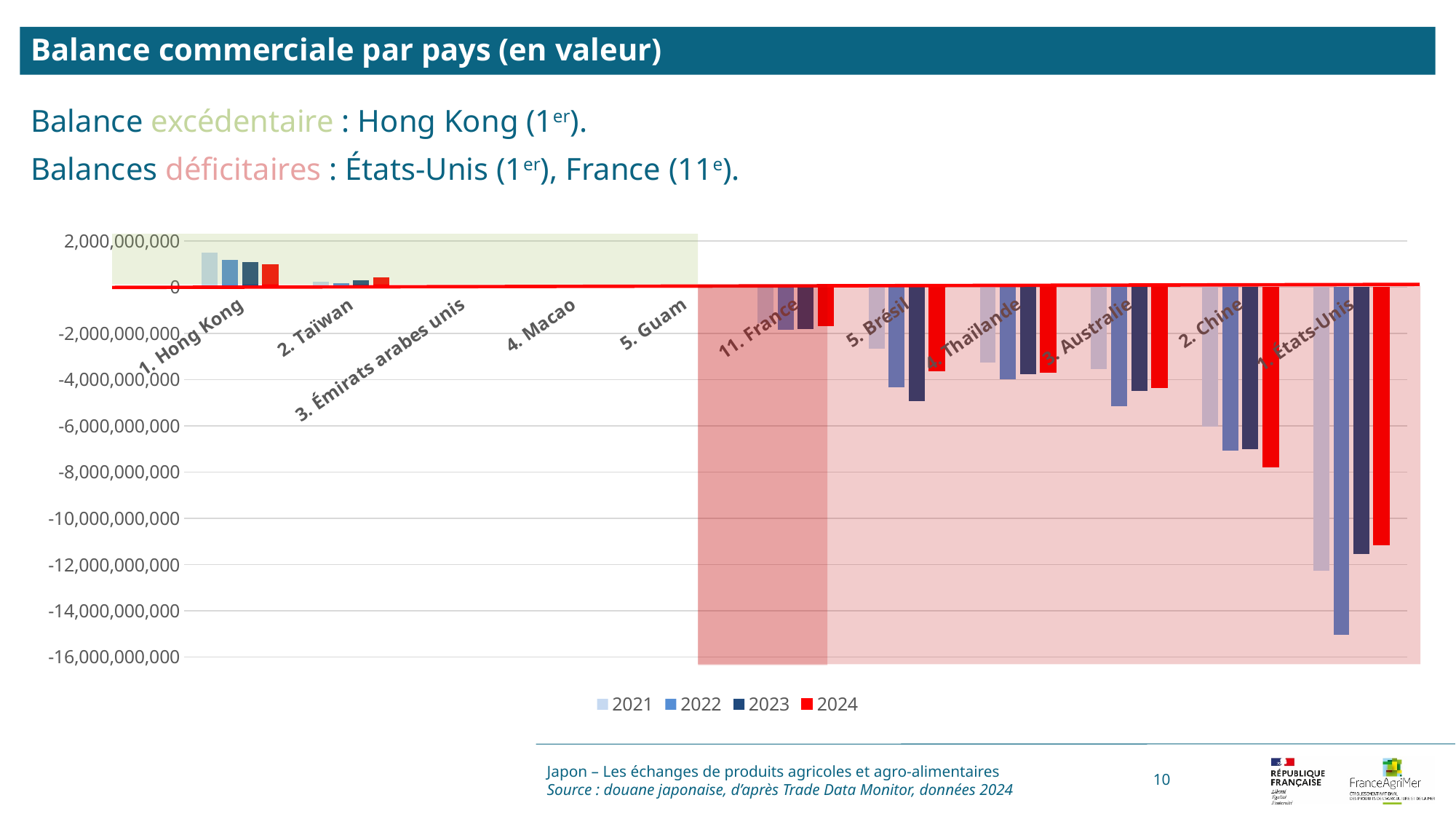
How many countries are shown on the x axis of the chart? 11 How many series does the chart legend list? 4 Is the 2021 value for 1. Hong Kong greater or less than 2,000,000,000? less Which is larger, the 2024 value for 3. Australie or the 2024 value for 2. Chine? 3. Australie Which country has the lowest (most negative) bar in the chart? 1. États-Unis Is the 2022 value for 1. États-Unis greater or less than -14,000,000,000? less Is the 2024 value for 2. Chine greater or less than -6,000,000,000? less Which country has the highest bar in the chart? 1. Hong Kong What kind of chart is shown on the slide? bar chart What is the title of the chart slide? Balance commerciale par pays (en valeur) For 1. Hong Kong, do the values rise or fall from 2021 to 2024? fall